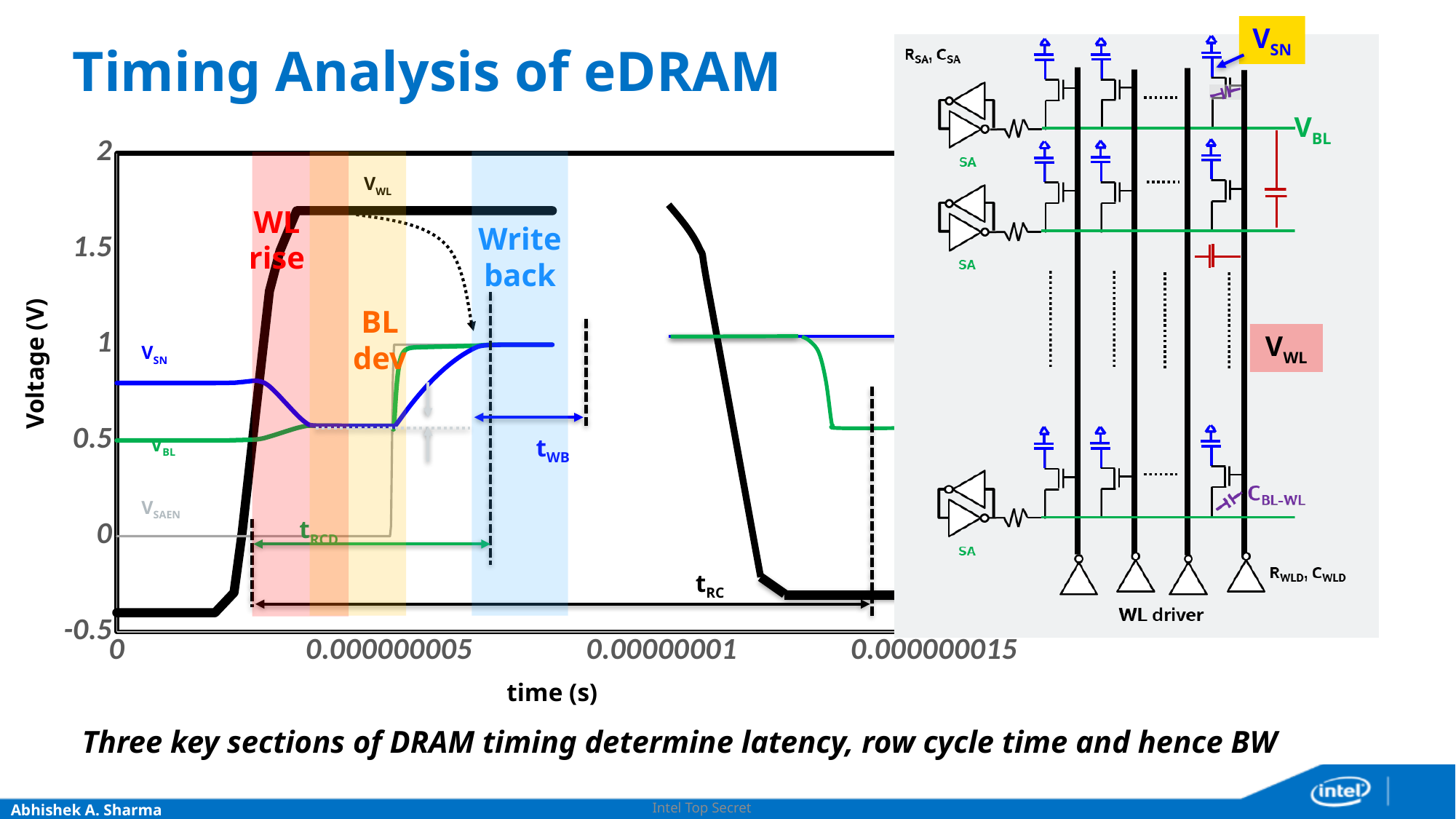
How does V_WL change along the x axis: does it rise, fall, or rise and then fall? rise and then fall What is the label of the x axis of the chart? time (s) What is the highest tick value shown on the y axis? 2 How many voltage traces are labelled on the chart? 4 What kind of chart is shown on the slide? line chart Is the initial value of V_WL (at time 0) greater or less than 0 V? less Which trace reaches the highest voltage on the chart? V_WL What is the label of the y axis of the chart? Voltage (V) How many highlighted timing sections (WL rise, BL dev, Write back) are marked on the chart? 3 Is the plateau value of V_WL greater or less than 1.5 V? greater Which is larger before the WL rise, V_SN or V_BL? V_SN Is the initial value of V_SN (before the WL rise) greater or less than 0.5 V? greater